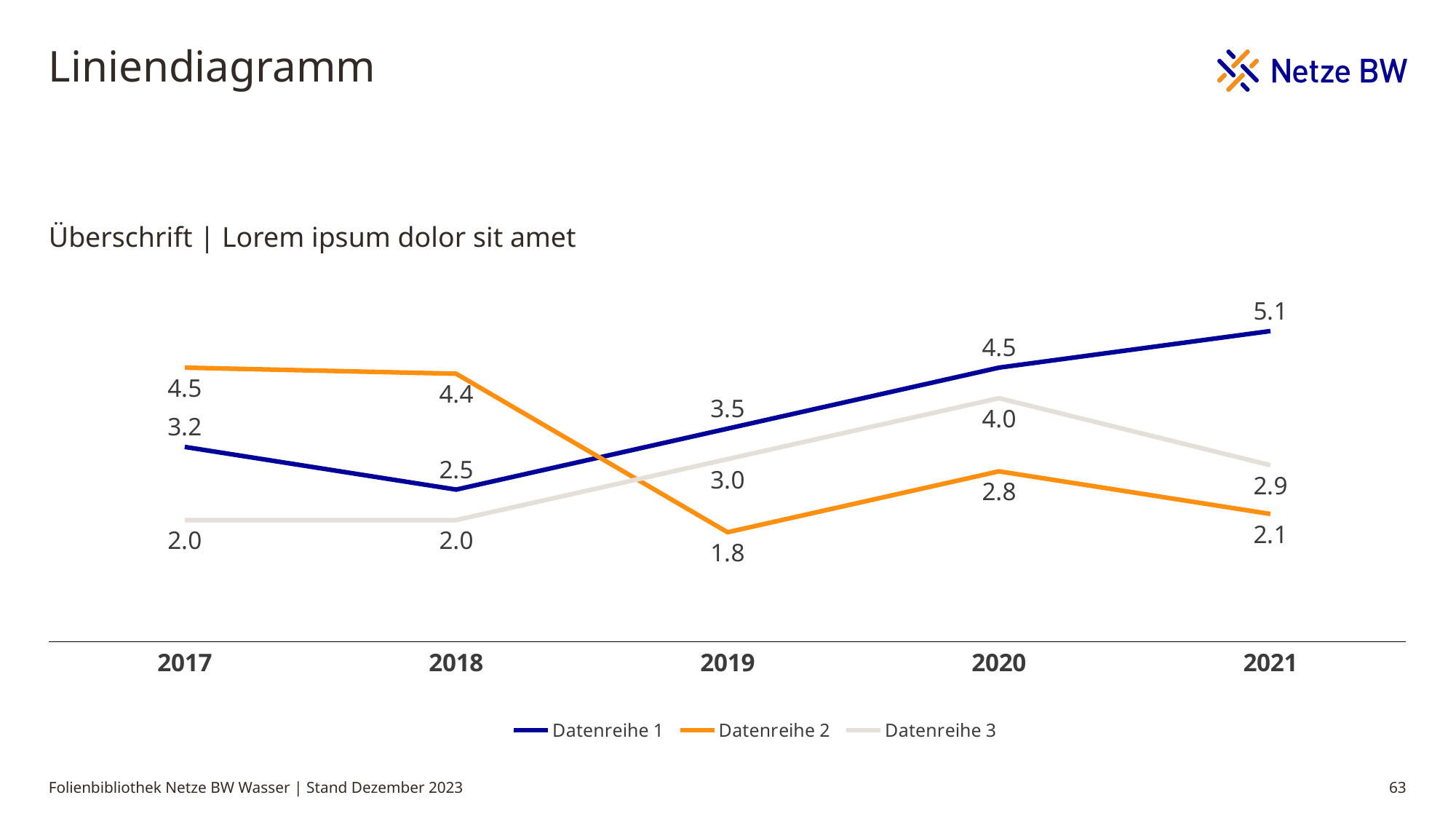
Which series has the higher value in 2017, Datenreihe 1 or Datenreihe 2? Datenreihe 2 How many series does the legend list? 3 What is the value of Datenreihe 1 in 2021? 5.1 In which year does Datenreihe 2 have its lowest value? 2019 What is the value of Datenreihe 2 in 2019? 1.8 What is the value of Datenreihe 3 in 2020? 4.0 In which year does Datenreihe 1 reach its highest value? 2021 What type of chart is shown on the slide? line chart Does Datenreihe 1 rise or fall from 2018 to 2021? rise Which colour is used for Datenreihe 2 in the chart? orange What is the difference between Datenreihe 1 and Datenreihe 2 in 2021? 3.0 How many years are shown on the x axis? 5